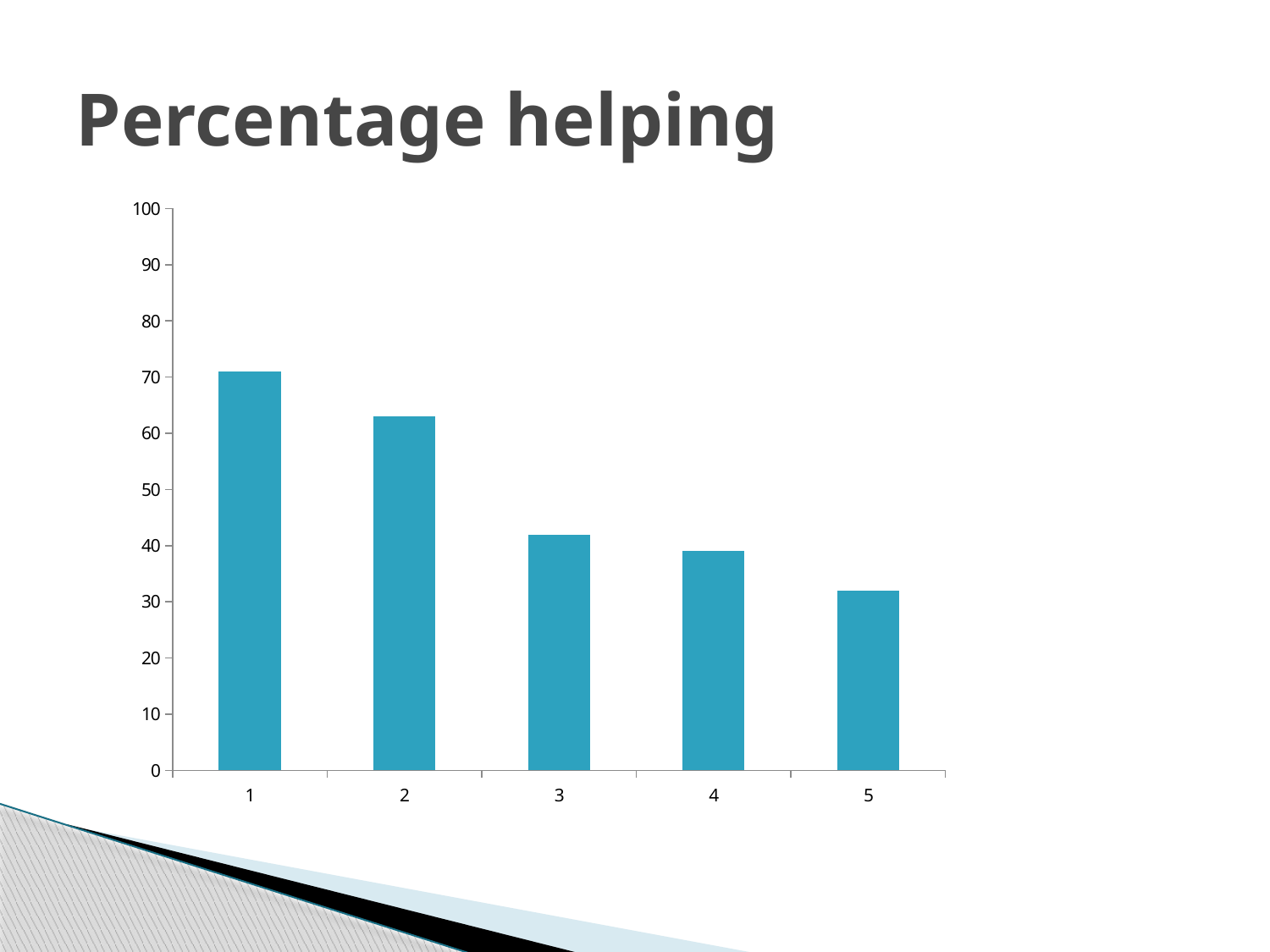
Is the value for category 3 greater or less than 50? less Which is larger, the value for category 2 or the value for category 4? 2 Which category has the lowest bar? 5 What is the title of the slide? Percentage helping Is the value for category 5 greater or less than 40? less How many bars are plotted in the chart? 5 Do the values rise or fall from category 1 to category 5? fall Is the value for category 2 greater or less than 60? greater Which category has the highest bar? 1 What kind of chart is shown on the slide? bar chart What is the maximum value shown on the vertical axis? 100